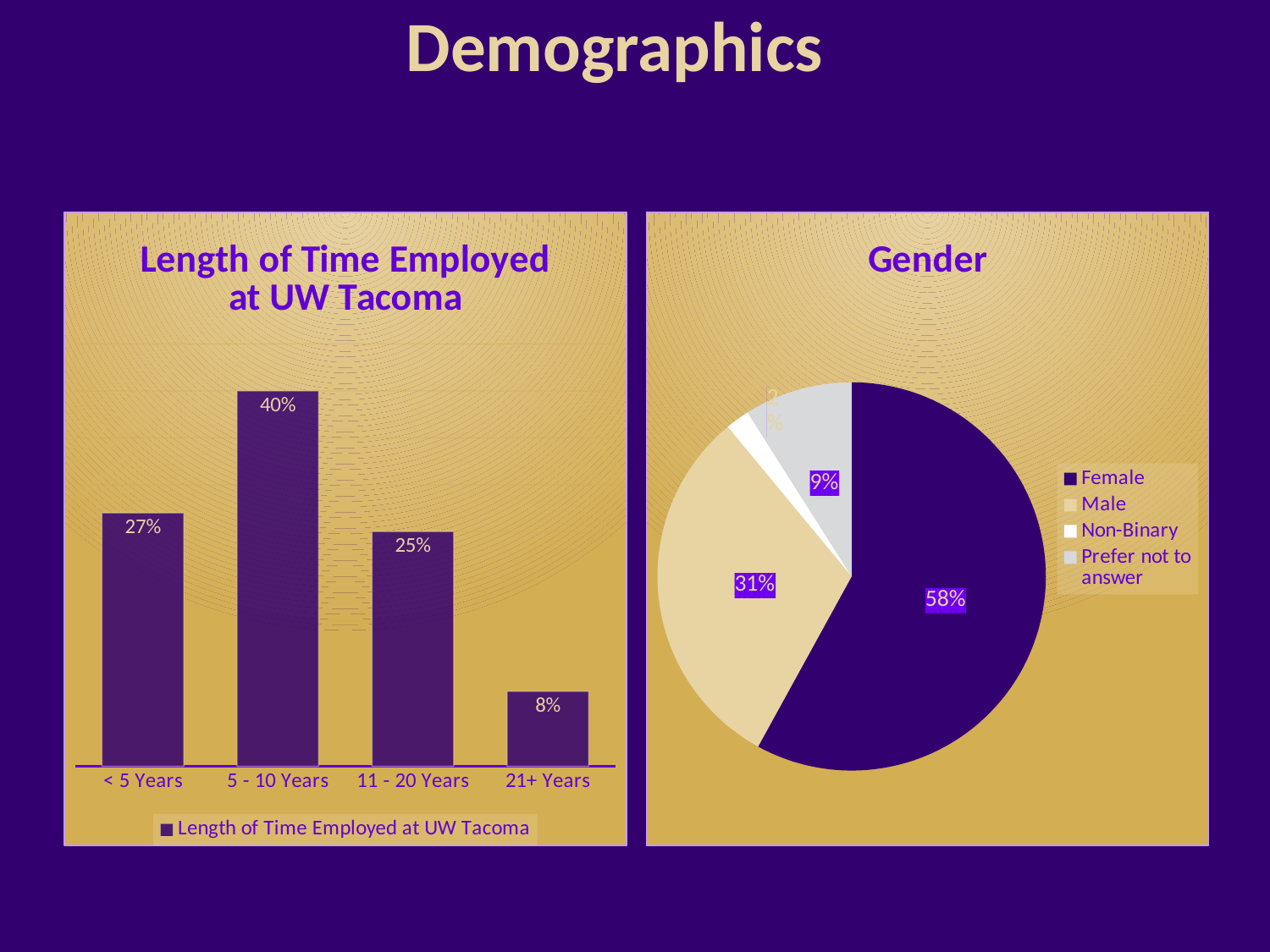
In the 'Length of Time Employed at UW Tacoma' chart, how many categories are shown on the x axis? 4 In the 'Length of Time Employed at UW Tacoma' chart, what is the value for 21+ Years? 8% In the 'Gender' chart, what share of the pie is Female? 58% How many entries does the legend of the 'Gender' chart list? 4 In the 'Length of Time Employed at UW Tacoma' chart, what is the difference between the values for < 5 Years and 11 - 20 Years? 2% In the 'Gender' chart, what share of the pie is Male? 31% In the 'Length of Time Employed at UW Tacoma' chart, what is the value for 5 - 10 Years? 40% In the 'Length of Time Employed at UW Tacoma' chart, which category has the highest value? 5 - 10 Years What kind of chart is the 'Length of Time Employed at UW Tacoma' chart? Bar chart In the 'Gender' chart, which is larger: Male or Prefer not to answer? Male In the 'Gender' chart, which category has the largest slice? Female In the 'Length of Time Employed at UW Tacoma' chart, which category has the lowest value? 21+ Years